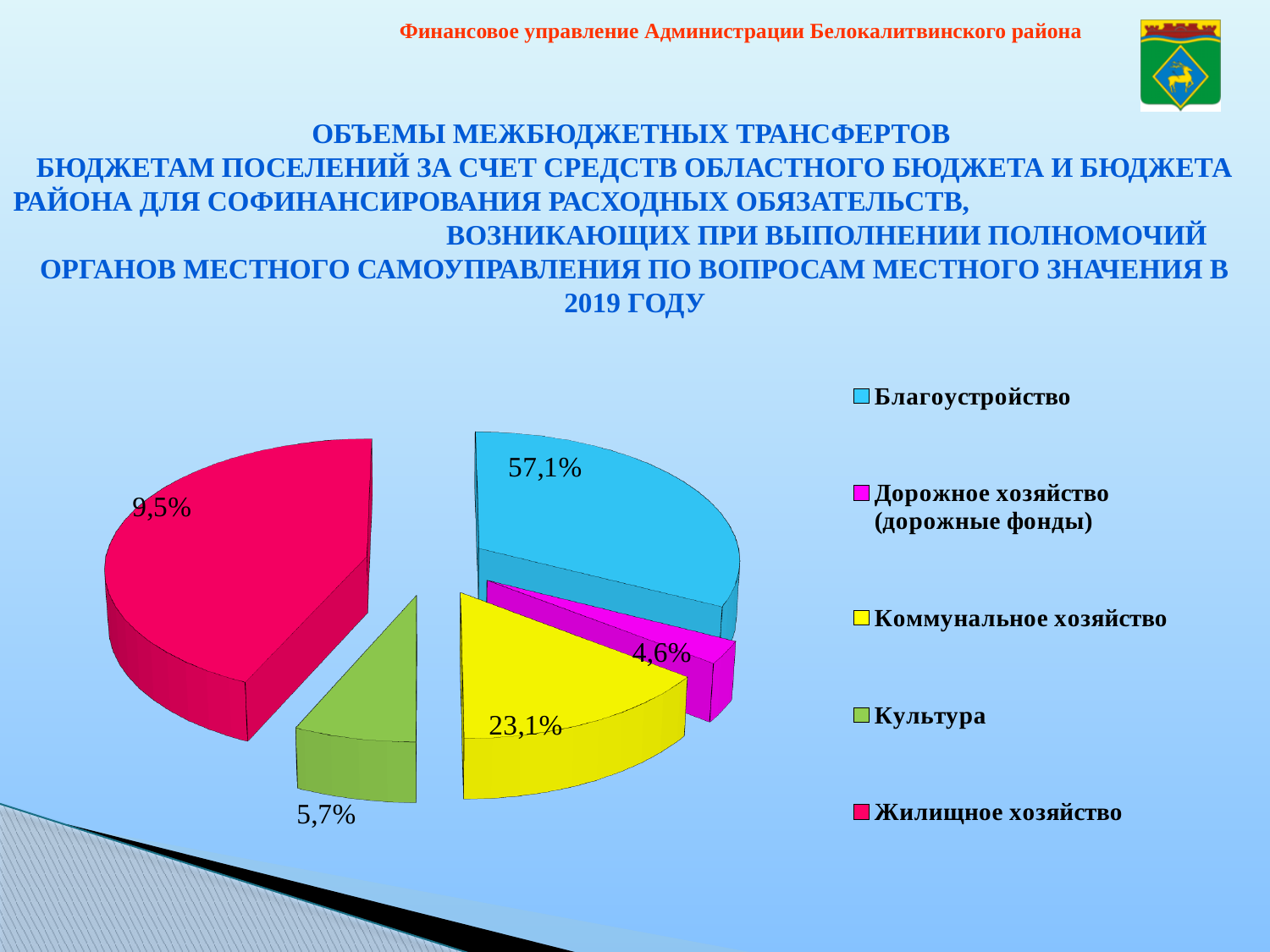
What share of the pie does Дорожное хозяйство (дорожные фонды) have? 4,6% What share of the pie does Коммунальное хозяйство have? 23,1% What share of the pie does Жилищное хозяйство have? 9,5% How many categories does the pie chart have? 5 Which is larger, the share for Жилищное хозяйство or the share for Культура? Жилищное хозяйство What is the difference in percentage points between Благоустройство and Коммунальное хозяйство? 34 percentage points What colour is the slice for Коммунальное хозяйство? yellow Which category has the smallest share of the pie? Дорожное хозяйство (дорожные фонды) Which category has the largest share of the pie? Благоустройство What kind of chart is shown on the slide? pie chart